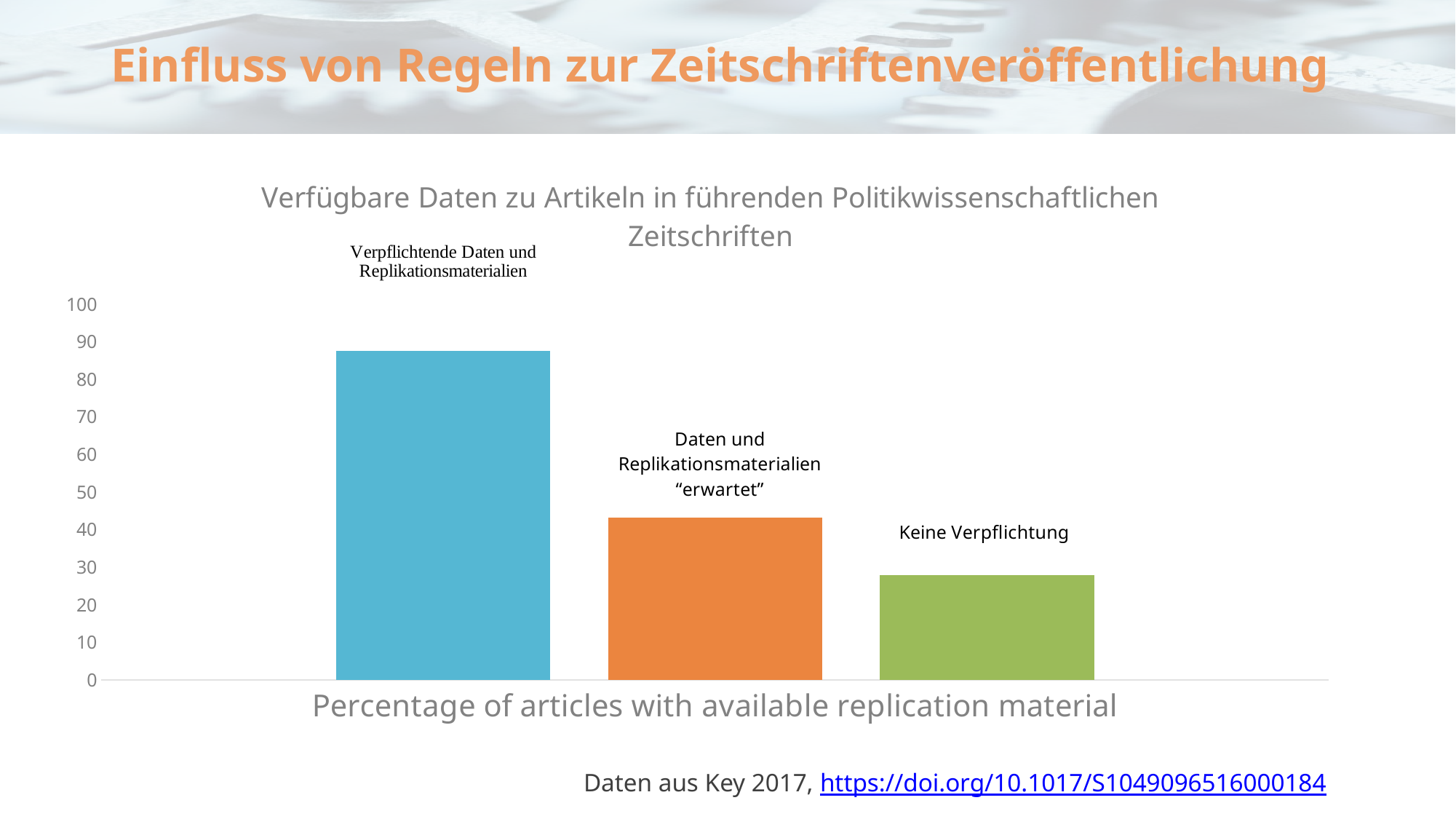
What is the title of the chart? Verfügbare Daten zu Artikeln in führenden Politikwissenschaftlichen Zeitschriften What kind of chart is shown on the slide? bar chart How many bars does the chart show? 3 Is the value for "Keine Verpflichtung" greater or less than 40? less Do the bar values rise or fall from left to right across the chart? fall What colour is the bar for "Keine Verpflichtung"? green Is the value for "Daten und Replikationsmaterialien 'erwartet'" greater or less than 50? less Which category has the highest percentage of articles with available replication material? Verpflichtende Daten und Replikationsmaterialien Which is larger: the value for "Daten und Replikationsmaterialien 'erwartet'" or the value for "Keine Verpflichtung"? Daten und Replikationsmaterialien "erwartet" Is the value for "Keine Verpflichtung" greater or less than 20? greater Which category has the lowest percentage of articles with available replication material? Keine Verpflichtung